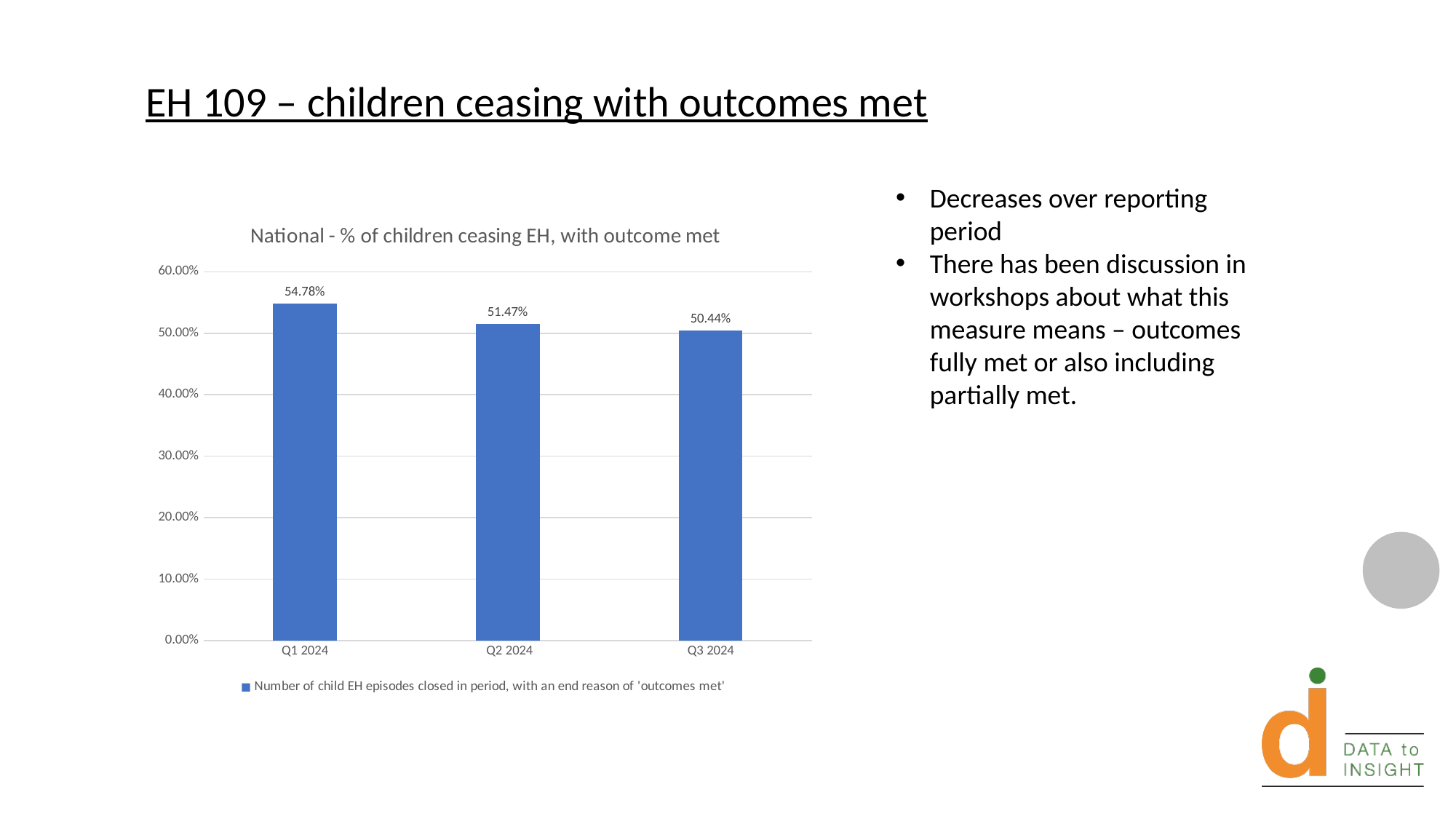
What is the value for Q1 2024? 54.78% What is the value for Q3 2024? 50.44% What kind of chart is shown on the slide? Bar chart How many quarters are shown on the chart? 3 Which is larger, the value for Q2 2024 or Q3 2024? Q2 2024 Which quarter has the lowest value? Q3 2024 Is the value for Q1 2024 greater or less than 50.00%? greater What is the difference between the values for Q1 2024 and Q3 2024? 4.34% Which quarter has the highest value? Q1 2024 Do the values rise or fall from Q1 2024 to Q3 2024? Fall What is the difference between the values for Q1 2024 and Q2 2024? 3.31% What is the value for Q2 2024? 51.47%